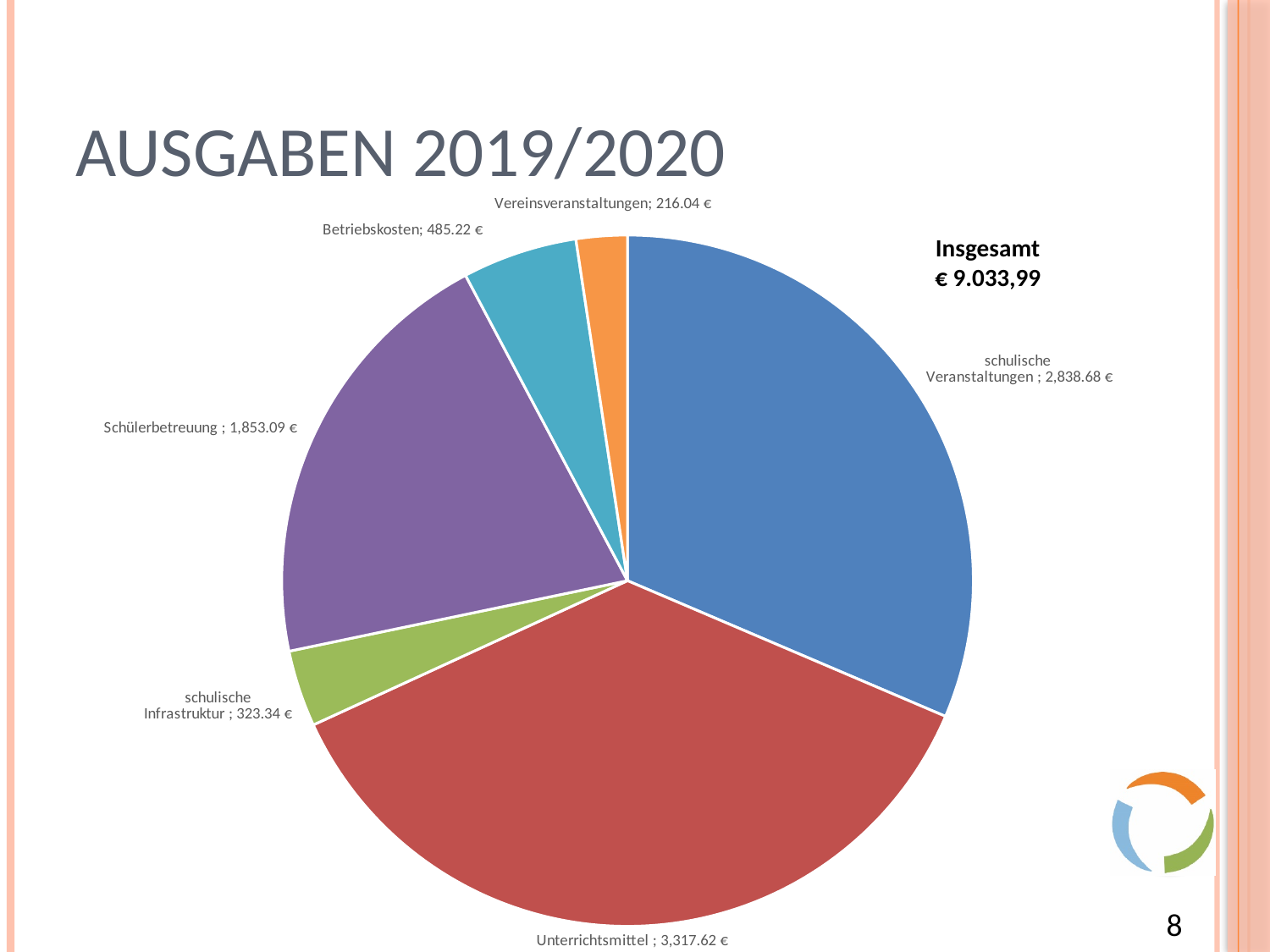
What is the value for Vereinsveranstaltungen? 216.04 € What is the value for Schülerbetreuung? 1,853.09 € Which category has the smallest slice of the pie? Vereinsveranstaltungen What is the value for schulische Veranstaltungen? 2,838.68 € What is the difference between Unterrichtsmittel and schulische Veranstaltungen? 478.94 € What is the difference between Betriebskosten and Vereinsveranstaltungen? 269.18 € What is the value for Unterrichtsmittel? 3,317.62 € What kind of chart is shown on the slide? Pie chart Which is larger, Betriebskosten or schulische Infrastruktur? Betriebskosten Which category has the largest slice of the pie? Unterrichtsmittel What total amount (Insgesamt) is stated on the slide? € 9.033,99 How many categories does the pie chart show? 6